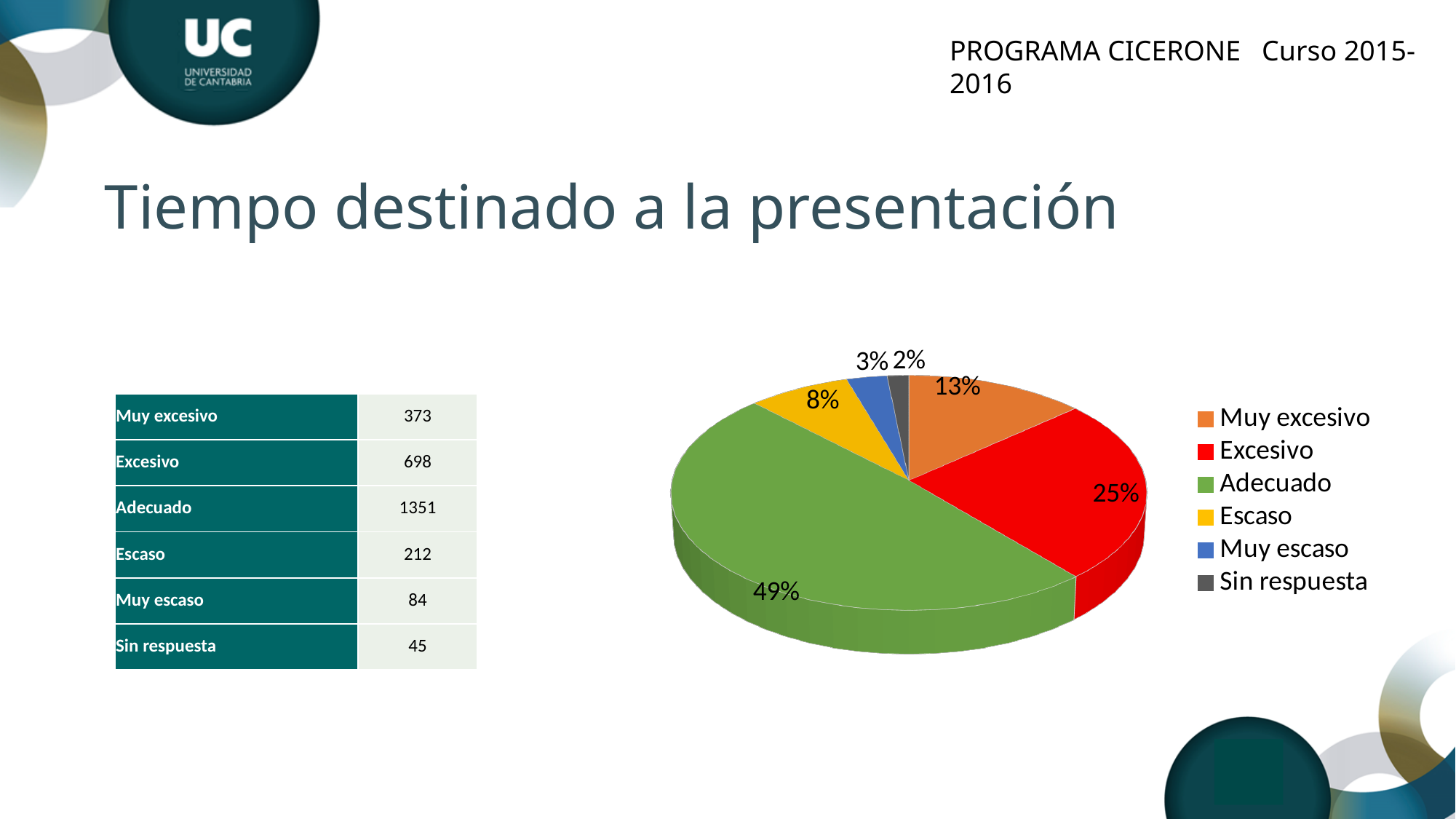
Which category has the smallest slice of the pie? Sin respuesta What percentage is shown for the Sin respuesta slice? 2% What percentage is shown for the Muy excesivo slice? 13% Which slice is larger, Excesivo or Muy excesivo? Excesivo What share of the pie does the Adecuado slice represent? 49% What is the difference in percentage points between the Adecuado and Excesivo slices? 24 How many slices does the pie chart have? 6 What kind of chart is shown on the slide? pie chart Which category has the largest slice of the pie? Adecuado What colour is the Escaso slice in the pie chart? yellow What percentage is shown for the Excesivo slice? 25% What share of the pie does the Escaso slice represent? 8%